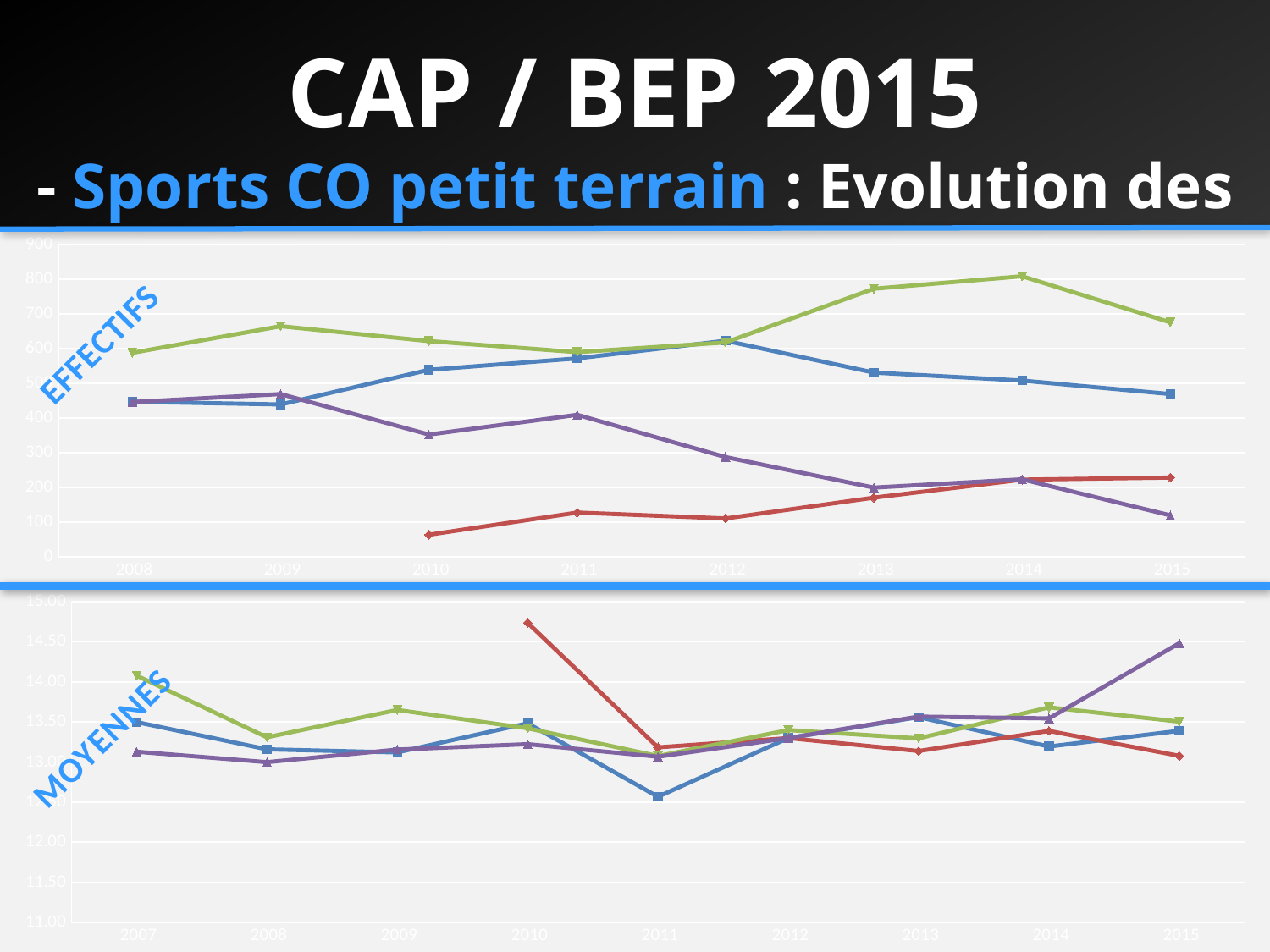
How many years are shown on the x axis of the bottom chart (MOYENNES)? 9 How many years are shown on the x axis of the top chart (EFFECTIFS)? 8 In the top chart (EFFECTIFS), in which year does the green line reach its highest value? 2014 In the bottom chart (MOYENNES), is the value of the red line in 2010 greater or less than 14.50? greater In the bottom chart (MOYENNES), is the value of the purple line in 2015 greater or less than 14.00? greater What kind of chart is the top chart labelled EFFECTIFS? line chart In the top chart (EFFECTIFS), which line is higher in 2013, the green line or the blue line? the green line How many lines are plotted in the top chart (EFFECTIFS)? 4 In the top chart (EFFECTIFS), is the value of the green line in 2014 greater or less than 700? greater In the top chart (EFFECTIFS), does the purple line rise or fall from 2011 to 2015? fall